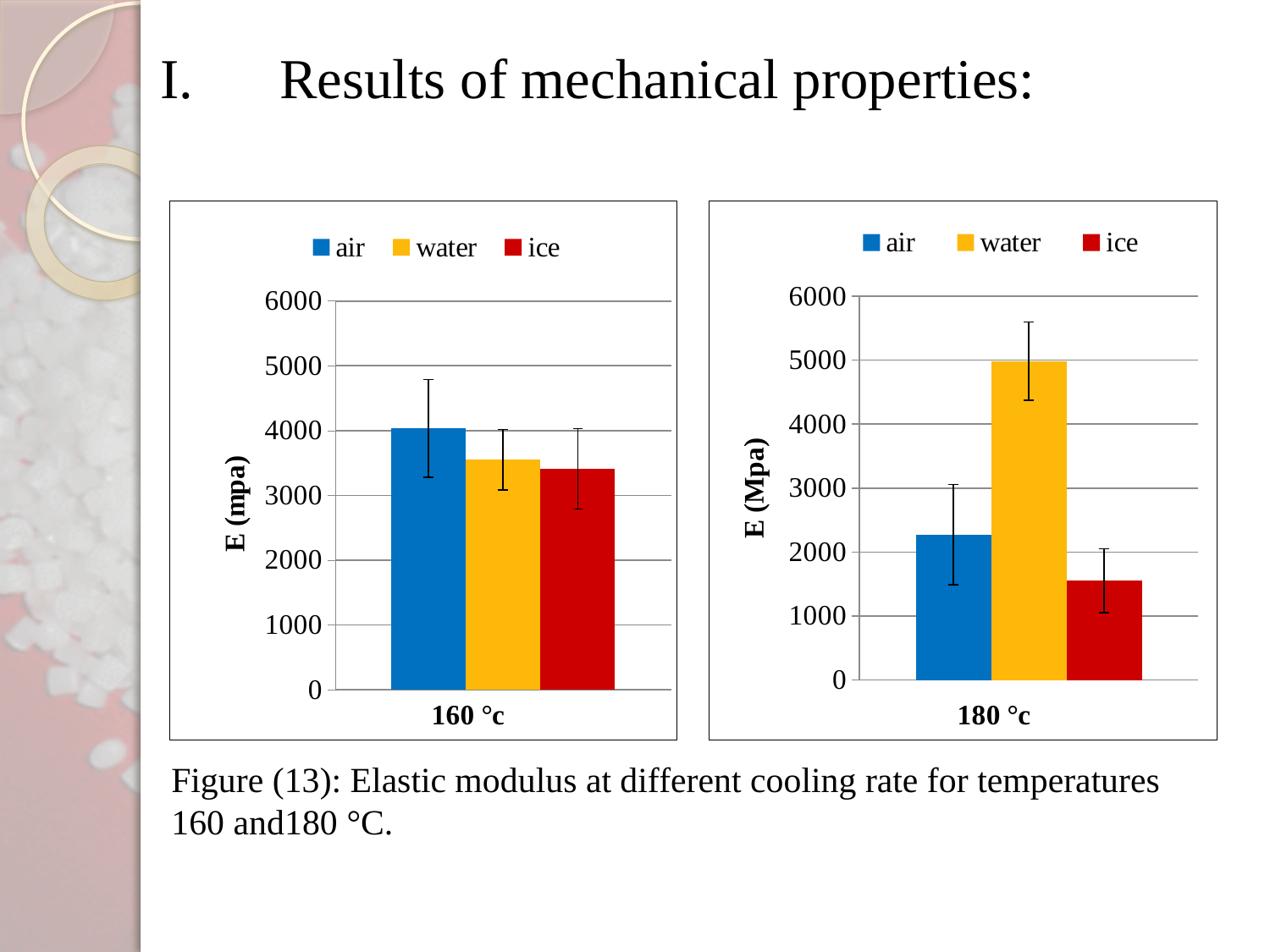
In the right chart (180 °c), what is the label on the vertical axis? E (Mpa) In the right chart (180 °c), which series has the highest value? water In the left chart (160 °c), how many series does the legend list? 3 In the left chart (160 °c), is the value for water greater or less than 4000? less In the left chart (160 °c), is the value for air greater or less than 3000? greater In the left chart (160 °c), which is larger, the value for air or the value for water? air In the right chart (180 °c), is the value for ice greater or less than 2000? less In the right chart (180 °c), which series has the lowest value? ice In the right chart (180 °c), which is larger, the value for air or the value for water? water What kind of chart is the left chart labelled 160 °c? bar chart In the left chart (160 °c), which series has the highest value? air